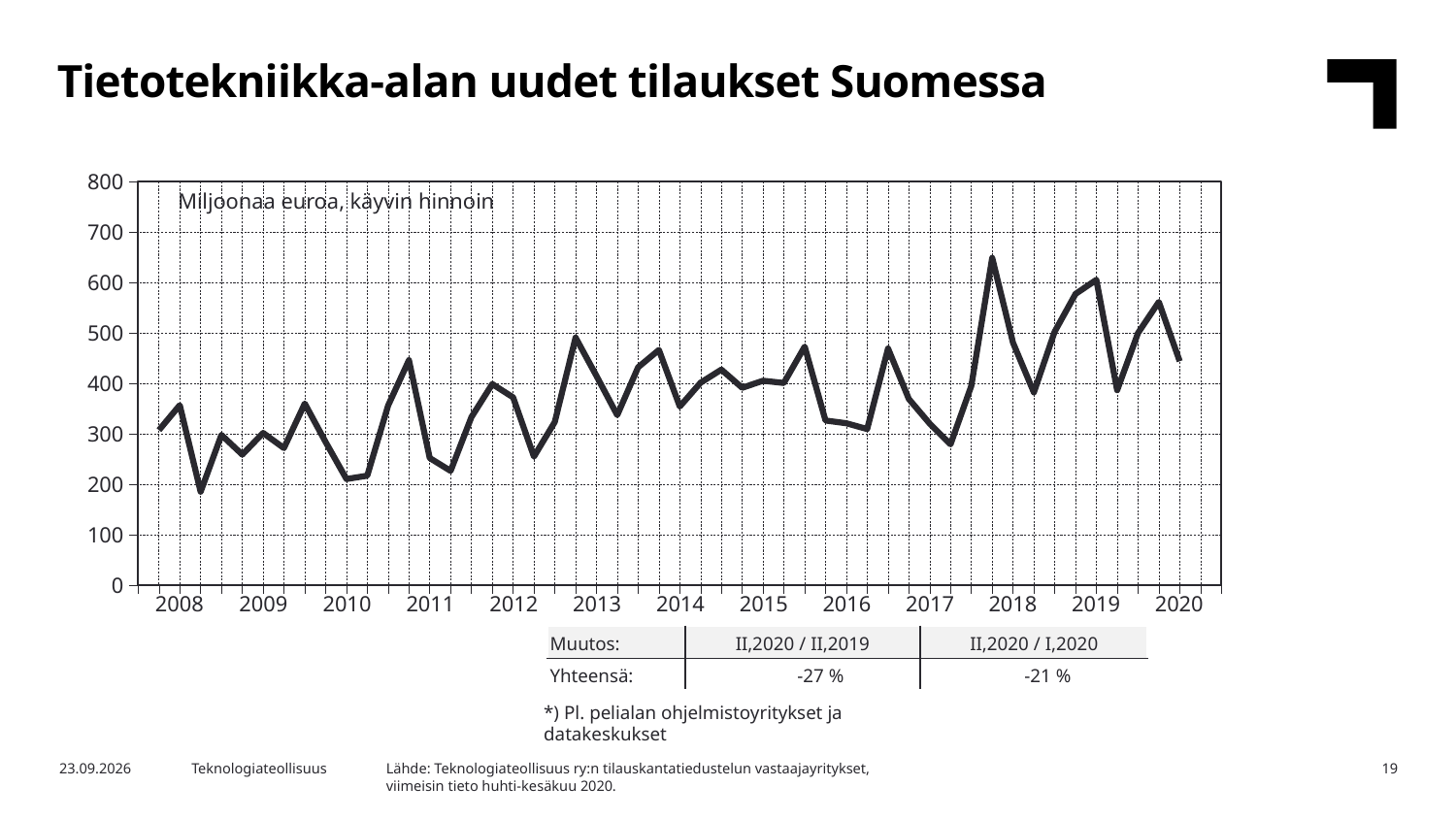
Is the last plotted value in 2020 greater or less than 400? greater What is the title of the chart? Tietotekniikka-alan uudet tilaukset Suomessa Is the lowest value in 2008 greater or less than 300? less What kind of chart is shown on the slide? line chart What is the highest value shown on the y axis? 800 In which year does the line reach its highest peak? 2018 Does the line rise or fall between the end of 2017 and the peak in early 2018? rise In which year does the line reach its lowest point? 2008 Which is higher, the peak in 2018 or the peak in 2013? 2018 Is the peak value in 2018 greater or less than 600? greater In what unit are the values on the chart expressed, according to the label inside the plot area? Miljoonaa euroa, käyvin hinnoin How many year labels are shown on the x axis? 13